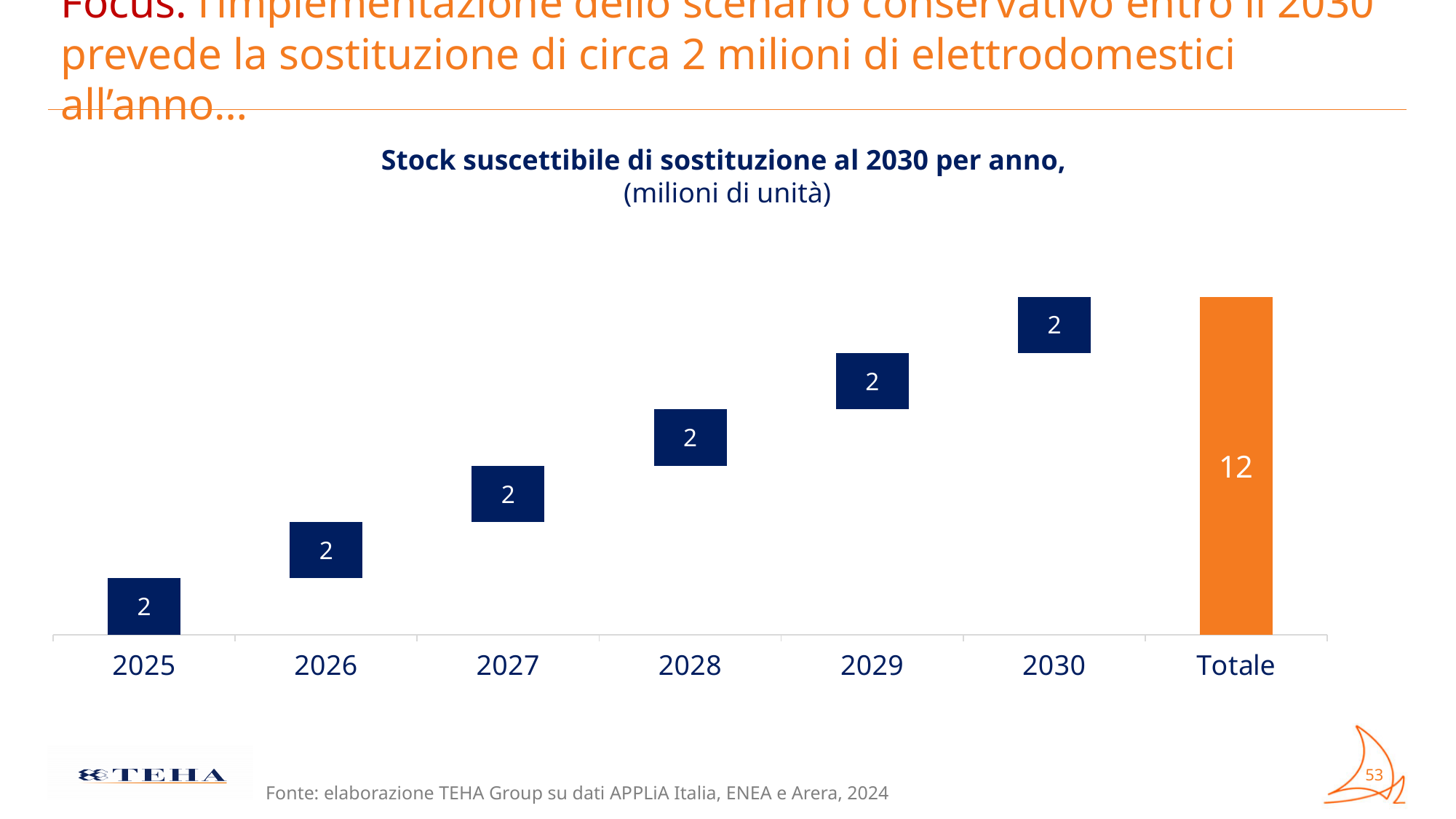
What is the value shown for the Totale bar? 12 What is the value shown for 2025 in the chart? 2 How many years (excluding Totale) are shown in the chart? 6 What is the value shown for 2028 in the chart? 2 Which is larger, the value for 2029 or the value for Totale? Totale What is the sum of the yearly values from 2025 to 2030? 12 What is the difference between the Totale value and the 2030 value? 10 What kind of chart is shown on the slide? bar chart How many categories are shown on the x axis of the chart? 7 Do the yearly values rise, fall or stay constant from 2025 to 2030? stay constant Which category has the highest value in the chart? Totale What unit is stated in the chart title? milioni di unità